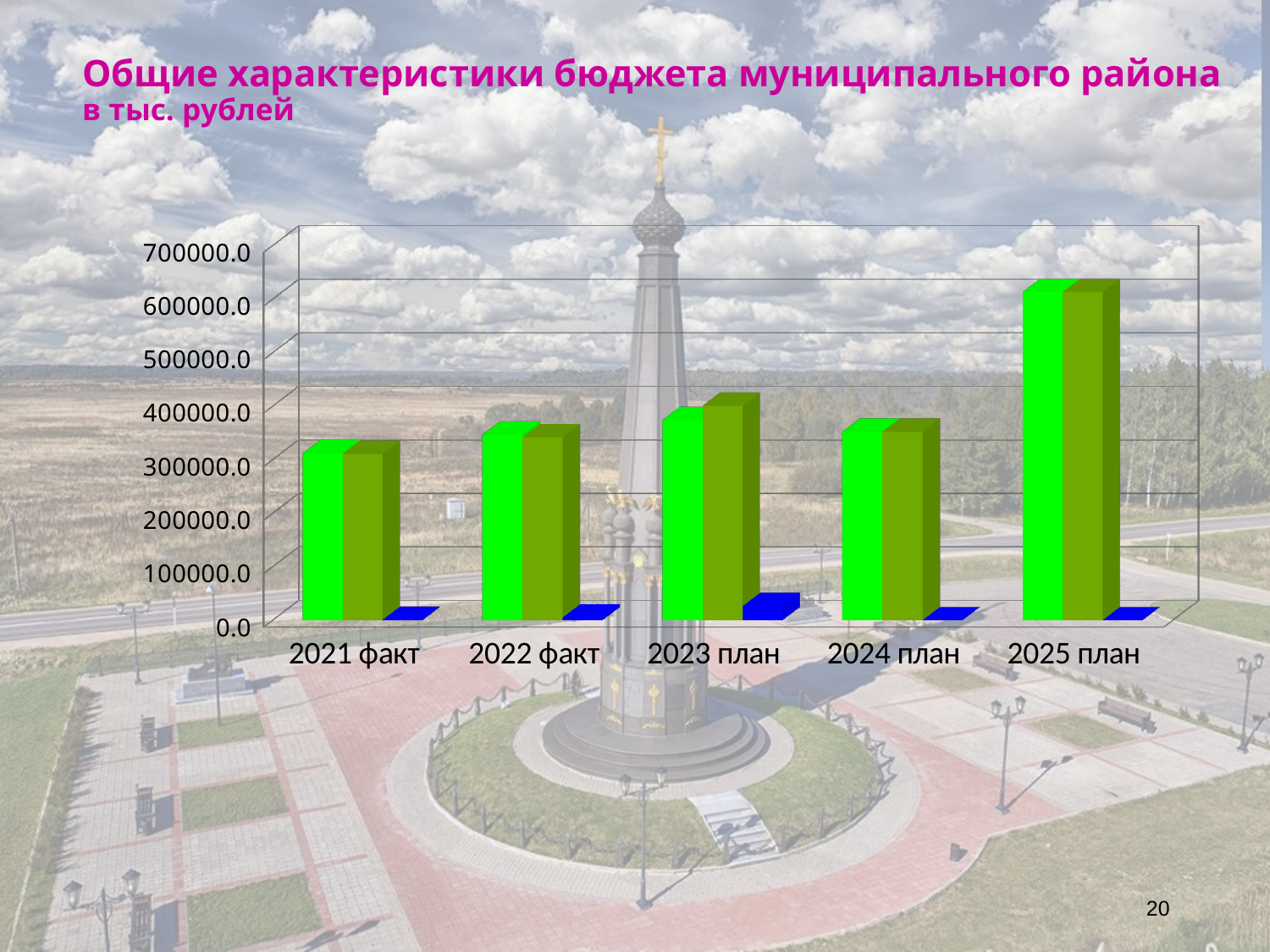
Is the green bar for 2023 план greater or less than 300000.0? greater Which green bar is taller, 2021 факт or 2025 план? 2025 план What is the title of the chart on the slide? Общие характеристики бюджета муниципального района в тыс. рублей Which category has the tallest green bar? 2025 план What kind of chart is shown on the slide? bar chart What is the highest value labelled on the vertical axis of the chart? 700000.0 Is the green bar for 2024 план greater or less than 500000.0? less Is the green bar for 2021 факт greater or less than 400000.0? less How many categories are shown on the x axis of the chart? 5 Which category has the shortest green bar? 2021 факт Which green bar is taller, 2023 план or 2024 план? 2023 план